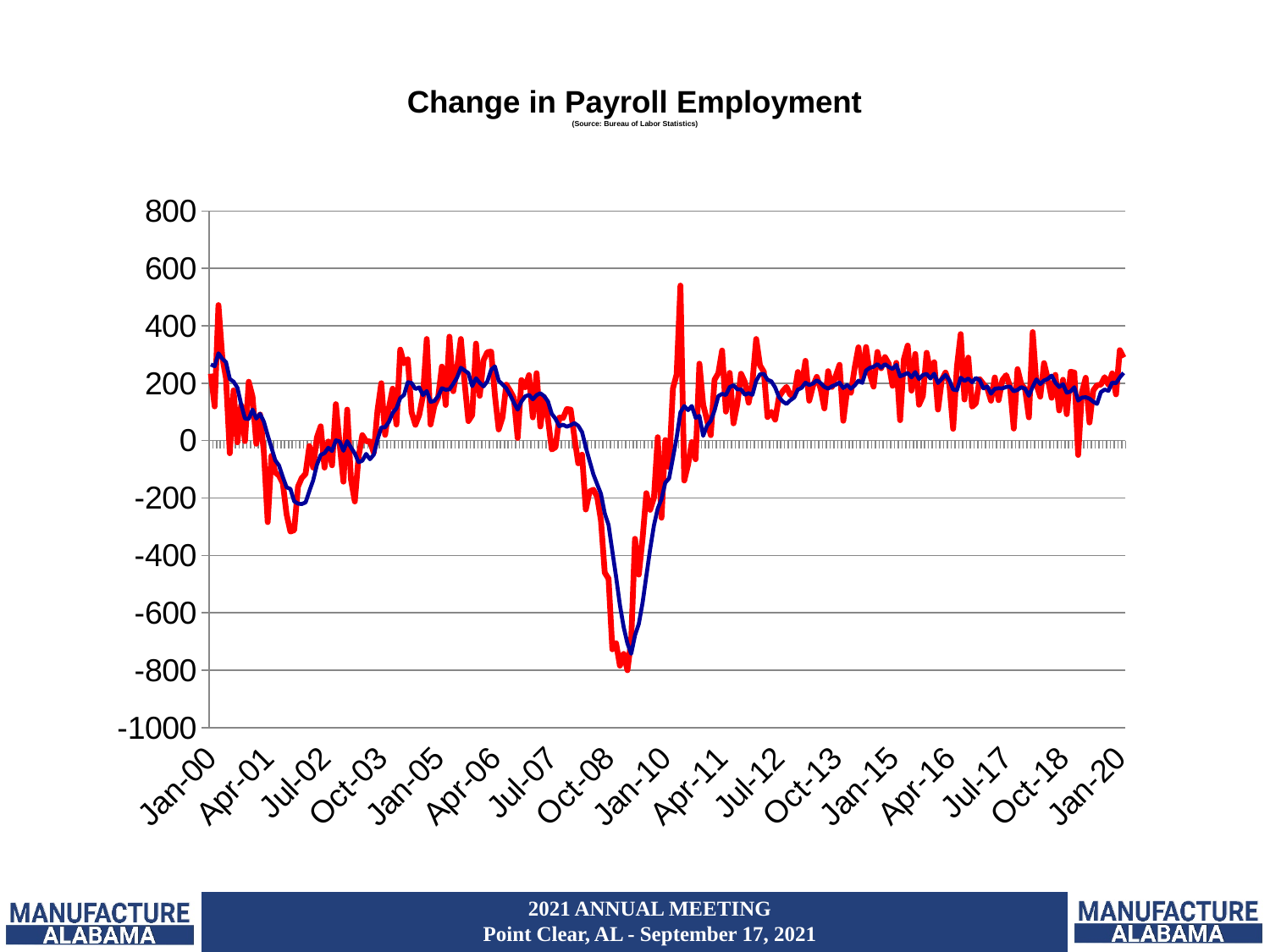
What source is cited beneath the chart title? Bureau of Labor Statistics What kind of chart is shown on the slide? line chart Between which two x-axis labels does the red line reach its lowest point? Oct-08 and Jan-10 Is the value of the red line at Jan-10 greater or less than -400? greater Do the values of the blue line rise or fall between Jan-00 and Jul-02? fall Is the value of the blue line at Jan-15 greater or less than 100? greater What is the lowest value shown on the y axis? -1000 Between which two x-axis labels does the red line reach its highest point? Jan-10 and Apr-11 How many date labels are shown along the x axis? 17 What is the highest value shown on the y axis? 800 Is the value of the red line at Oct-08 greater or less than 0? less What is the title of the chart? Change in Payroll Employment